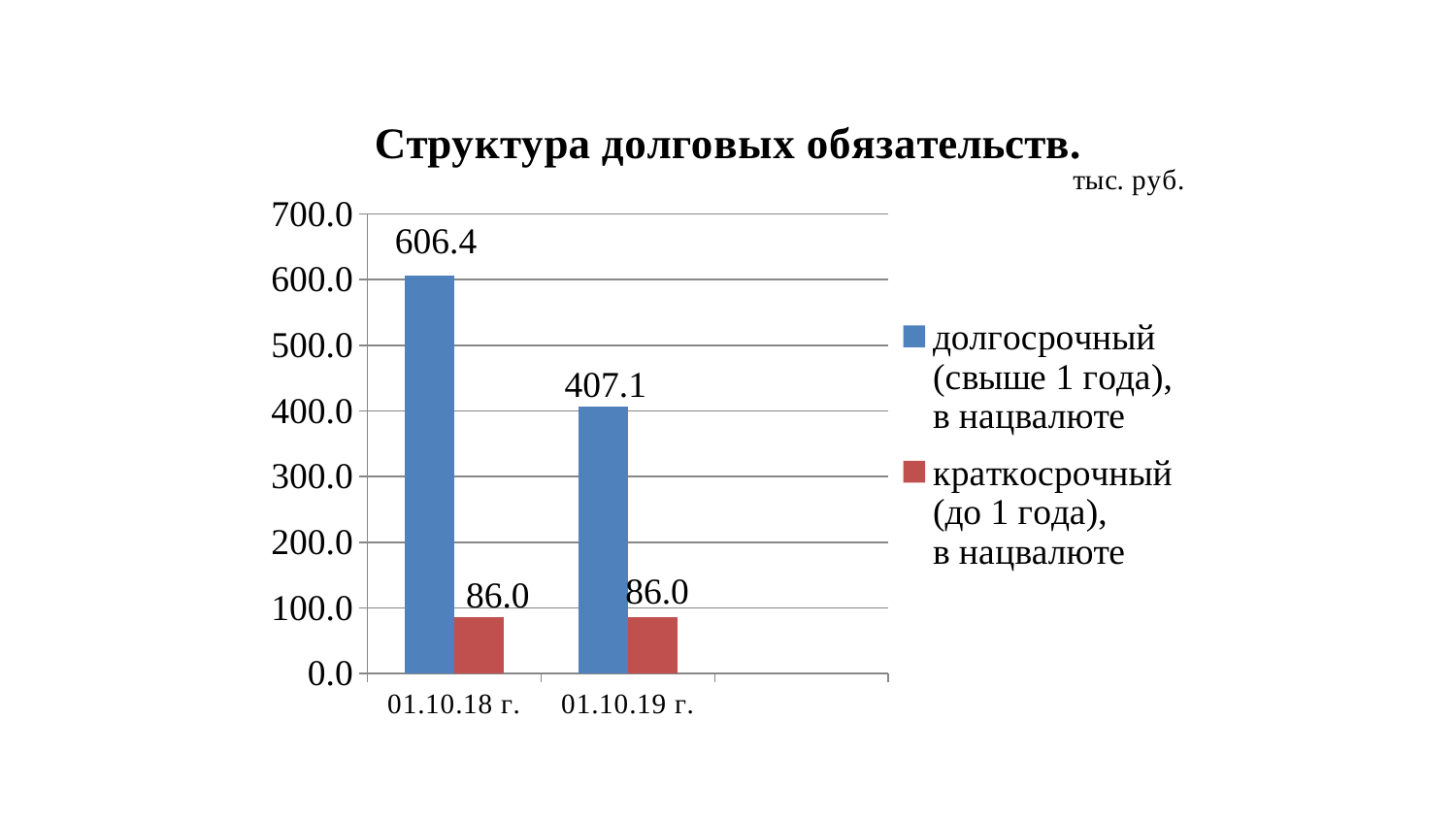
What is the value of краткосрочный (до 1 года), в нацвалюте for 01.10.18 г.? 86.0 How many series does the legend list? 2 Which is larger for 01.10.18 г.: долгосрочный or краткосрочный? долгосрочный What is the difference between the долгосрочный and краткосрочный values for 01.10.19 г.? 321.1 How many dates are shown on the x axis? 2 What is the difference between the долгосрочный values for 01.10.18 г. and 01.10.19 г.? 199.3 What is the value of долгосрочный (свыше 1 года), в нацвалюте for 01.10.18 г.? 606.4 Which date has the higher value for долгосрочный (свыше 1 года), в нацвалюте? 01.10.18 г. Is the value for долгосрочный on 01.10.19 г. greater or less than 500.0? less What type of chart is shown? bar chart What is the value of краткосрочный (до 1 года), в нацвалюте for 01.10.19 г.? 86.0 What is the value of долгосрочный (свыше 1 года), в нацвалюте for 01.10.19 г.? 407.1